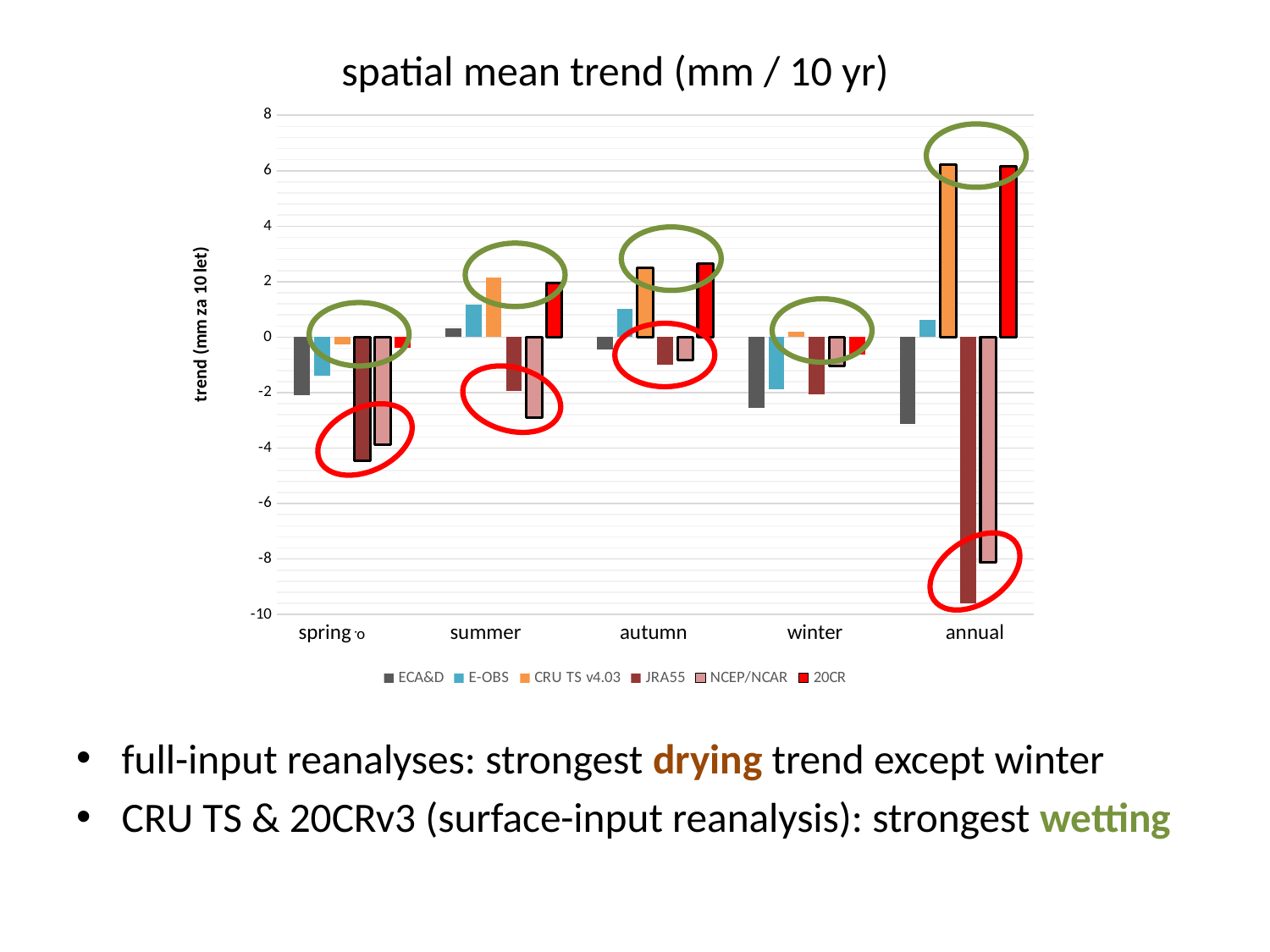
In the annual category, which is larger: the value for ECA&D or the value for E-OBS? E-OBS Is the annual value for CRU TS v4.03 greater or less than 4? greater How many series does the chart legend list? 6 Which series has the lowest value in the annual category? JRA55 How many categories are shown on the x axis of the chart? 5 Is the annual value for JRA55 greater or less than -8? less What kind of chart is shown on the slide? bar chart What is the title of the chart? spatial mean trend (mm / 10 yr) In summer, which is larger: the value for CRU TS v4.03 or the value for E-OBS? CRU TS v4.03 Is the winter value for ECA&D greater or less than -2? less Which series has the lowest value in the spring category? JRA55